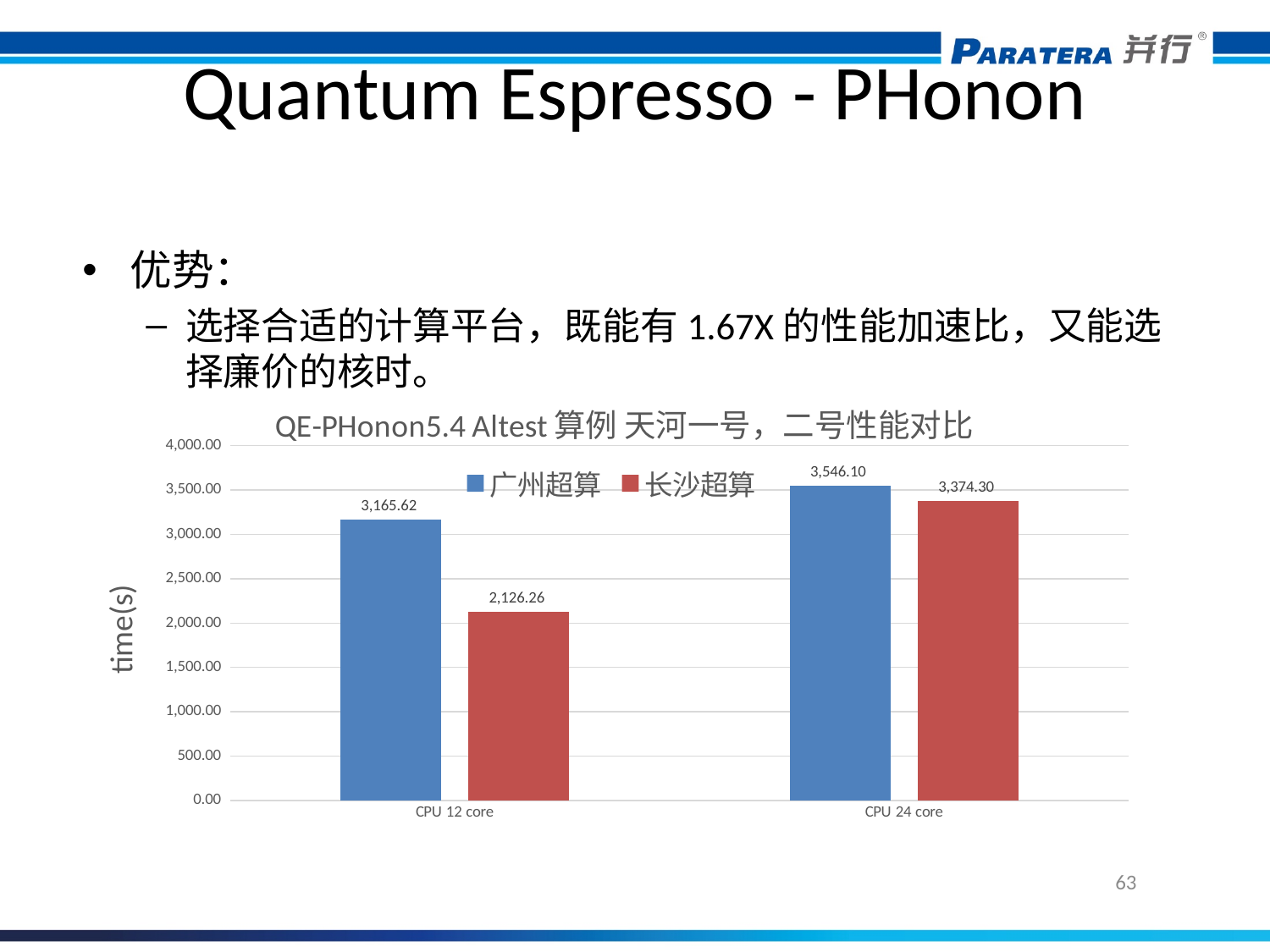
What is the label of the y axis? time(s) What is the difference between 广州超算 and 长沙超算 at CPU 24 core? 171.80 How many series does the legend list? 2 What kind of chart is shown on the slide? Bar chart Which bar has the lowest value in the chart? 长沙超算 at CPU 12 core What is the value for 广州超算 at CPU 24 core? 3,546.10 Which bar has the highest value in the chart? 广州超算 at CPU 24 core What is the value for 广州超算 at CPU 12 core? 3,165.62 What is the value for 长沙超算 at CPU 12 core? 2,126.26 What is the value for 长沙超算 at CPU 24 core? 3,374.30 What is the difference between 广州超算 and 长沙超算 at CPU 12 core? 1,039.36 Which is larger at CPU 12 core, 广州超算 or 长沙超算? 广州超算